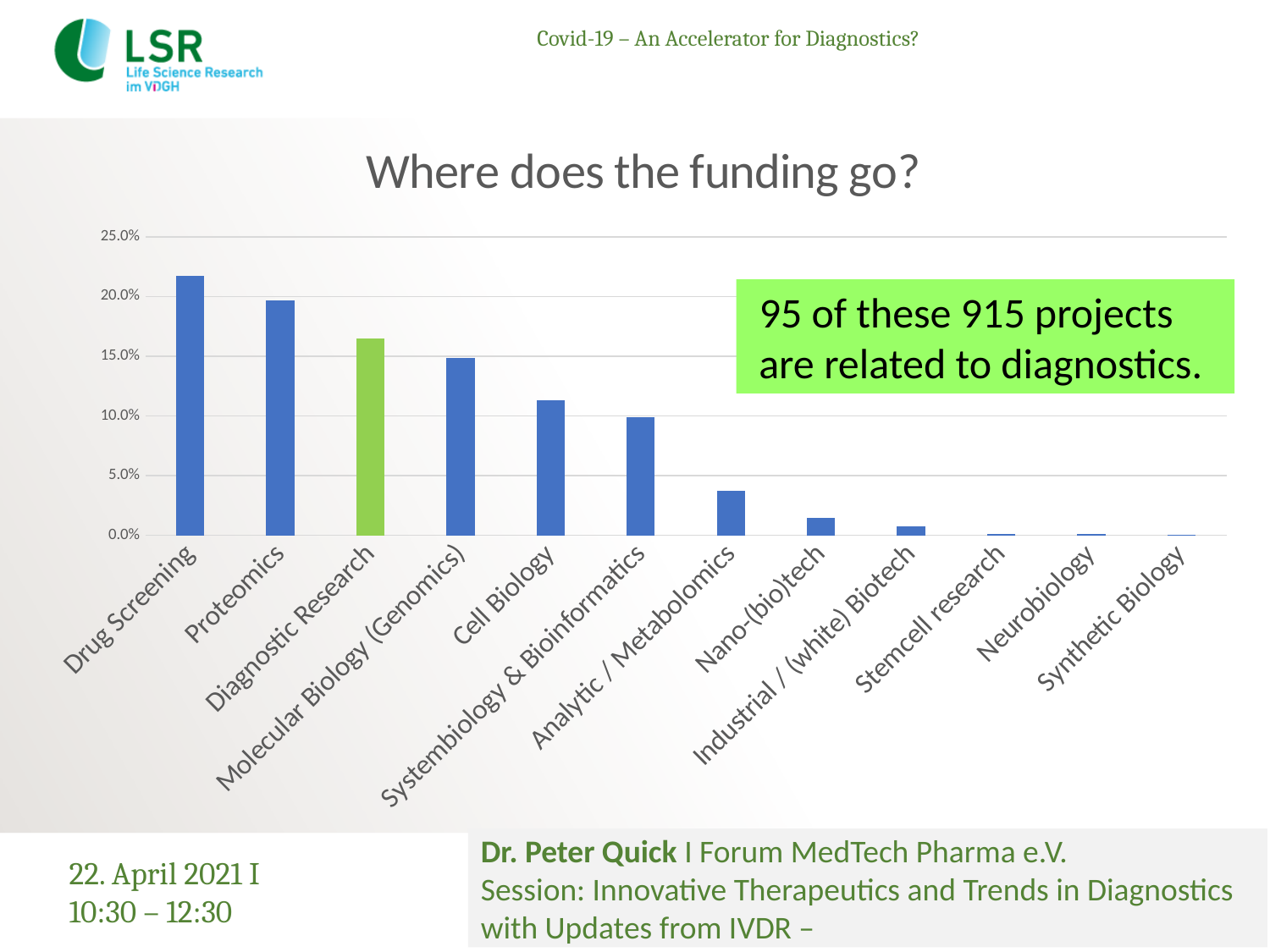
What is the title of the chart? Where does the funding go? Do the values rise or fall moving from left to right along the x axis? fall What kind of chart is shown on the slide? bar chart Is the value for Drug Screening greater or less than 20.0%? greater How many categories are shown on the x axis of the chart? 12 Which category has the highest value in the chart? Drug Screening Which has a larger value, Proteomics or Molecular Biology (Genomics)? Proteomics Which category's bar is coloured green instead of blue? Diagnostic Research Is the value for Cell Biology greater or less than 10.0%? greater Is the value for Diagnostic Research greater or less than 15.0%? greater